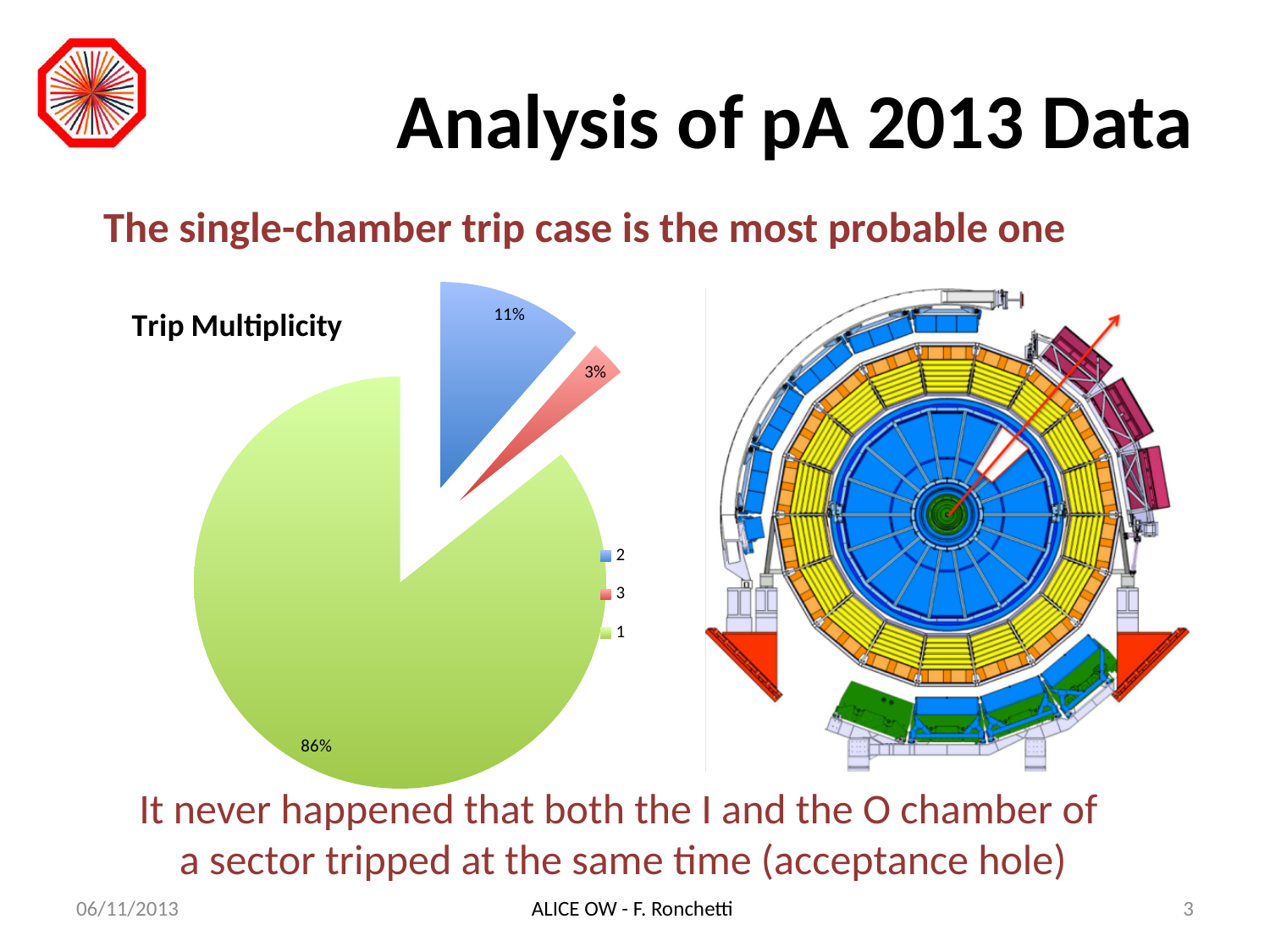
Which trip multiplicity has the smallest slice of the pie? 3 Which trip multiplicity has the largest slice of the pie? 1 What share of the pie does trip multiplicity 1 have? 86% What colour is the slice for trip multiplicity 1 in the pie chart? green What is the difference in percentage points between the slices for trip multiplicity 2 and trip multiplicity 3? 8% What kind of chart is shown on the slide? pie chart Which slice is larger, trip multiplicity 2 or trip multiplicity 3? 2 What share of the pie does trip multiplicity 2 have? 11% How many entries does the legend of the pie chart list? 3 What share of the pie does trip multiplicity 3 have? 3% How many slices does the pie chart have? 3 What is the title of the pie chart? Trip Multiplicity